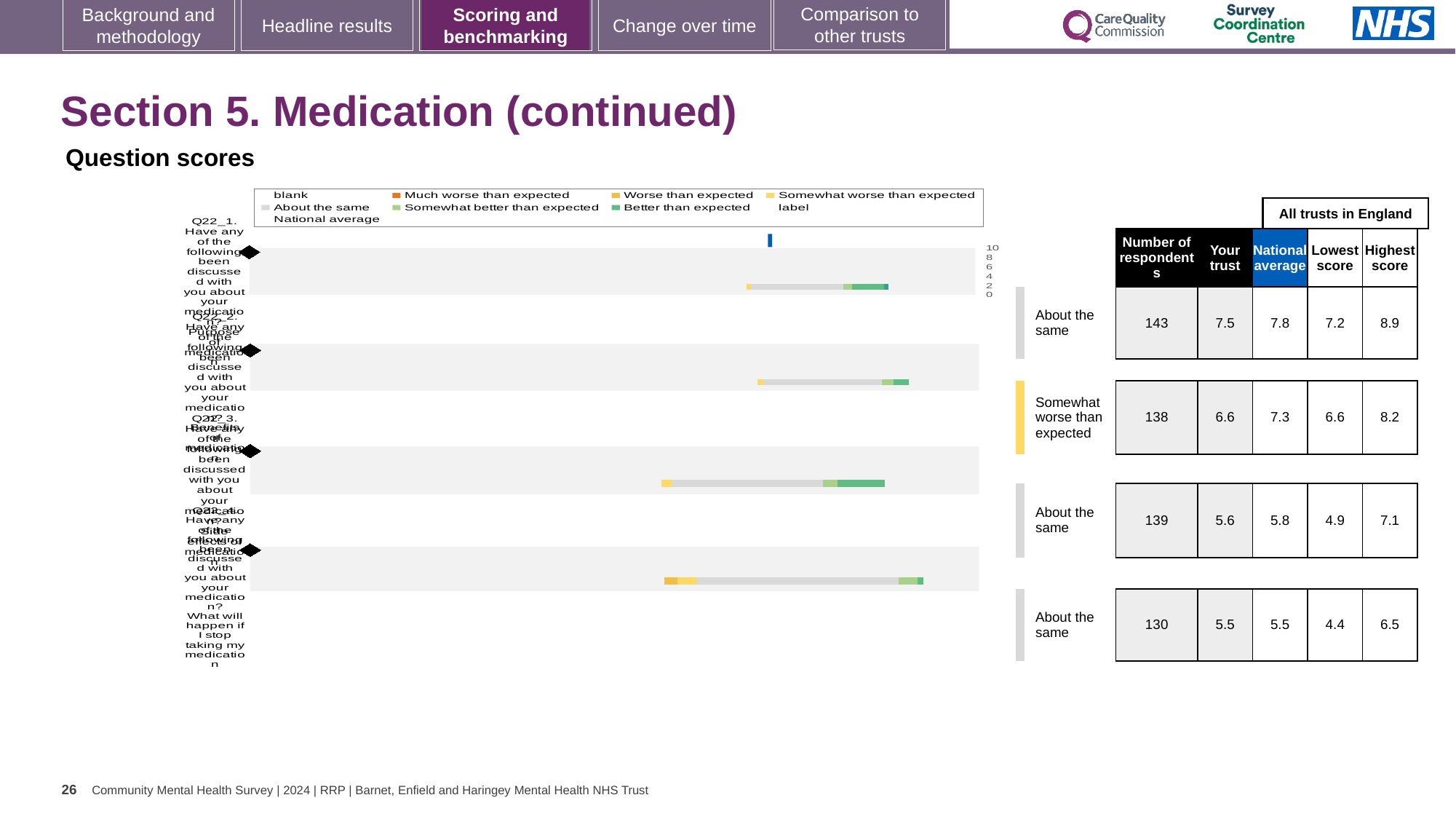
In the chart legend, what colour represents 'Better than expected'? green Is the 'Your trust' score for the first (top) row larger or smaller than its national average? smaller What is the 'Your trust' score for the first (top) question row? 7.5 What is the difference between the national average and the 'Your trust' score for the second question row from the top? 0.7 How many question rows are plotted in the chart? 4 What kind of chart is shown under 'Question scores'? bar chart How many respondents are listed for the third question row from the top? 139 Which question row has the lowest 'Your trust' score? the fourth (bottom) row, 5.5 Which question row is rated 'Somewhat worse than expected'? the second row from the top Which question row has the highest 'Your trust' score? the first (top) row, 7.5 In the chart legend, what colour represents 'Somewhat worse than expected'? yellow What is the national average for the second question row from the top? 7.3